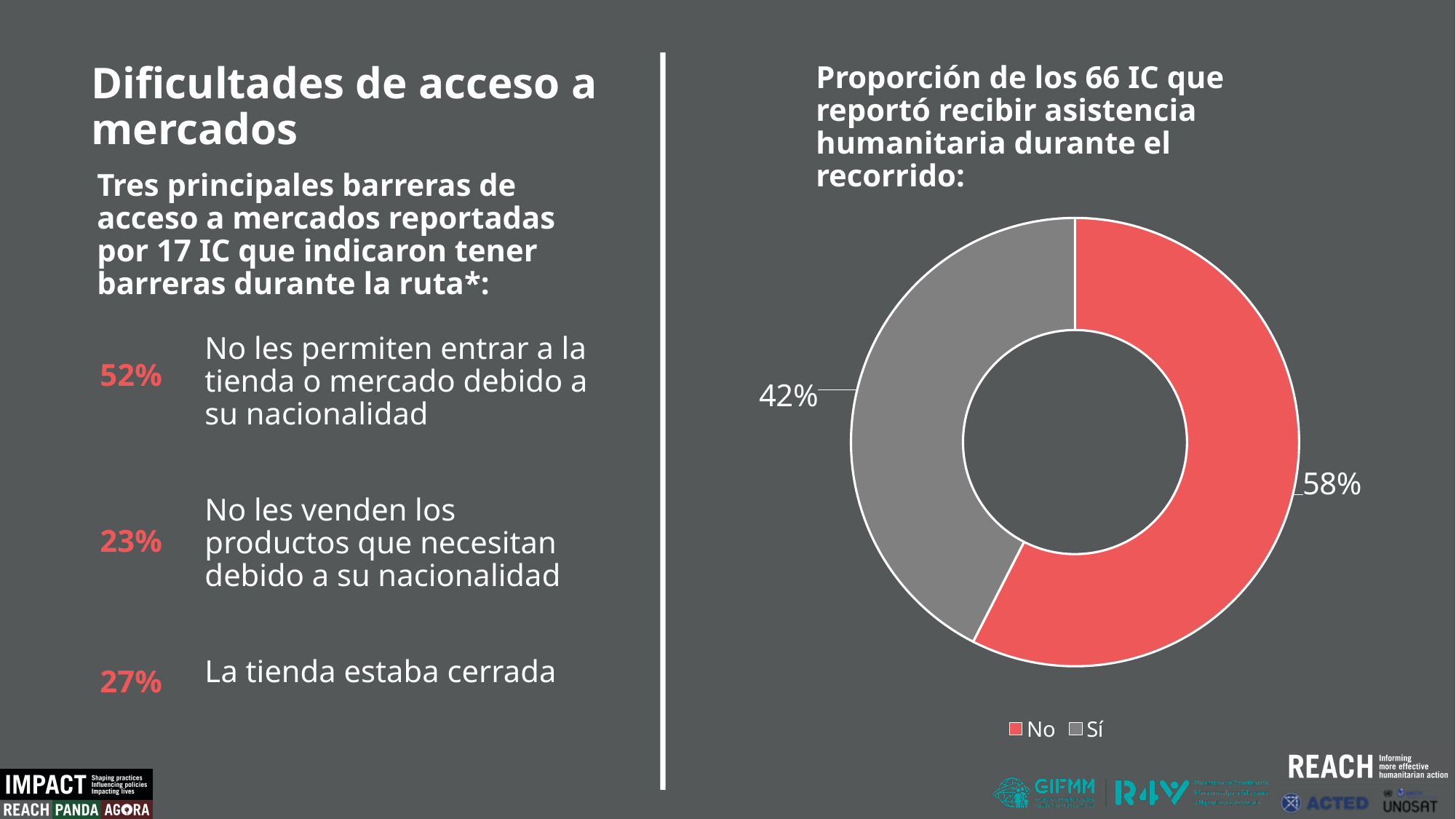
What colour represents 'No' in the doughnut chart? Red What is the difference in percentage points between the 'No' and 'Sí' slices? 16 Which category has the smallest share in the doughnut chart? Sí What kind of chart is shown on the right side of the slide? Doughnut (pie) chart Which category has the larger share in the doughnut chart, 'No' or 'Sí'? No What percentage of the 66 IC reported 'No' to receiving humanitarian assistance during the journey? 58% Is the share for 'Sí' in the doughnut chart greater or less than 50%? less How many categories does the legend of the doughnut chart list? 2 What is the total of the two slices shown in the doughnut chart? 100% What colour represents 'Sí' in the doughnut chart? Grey What percentage of the 66 IC reported 'Sí' to receiving humanitarian assistance during the journey? 42% How many slices does the doughnut chart have? 2